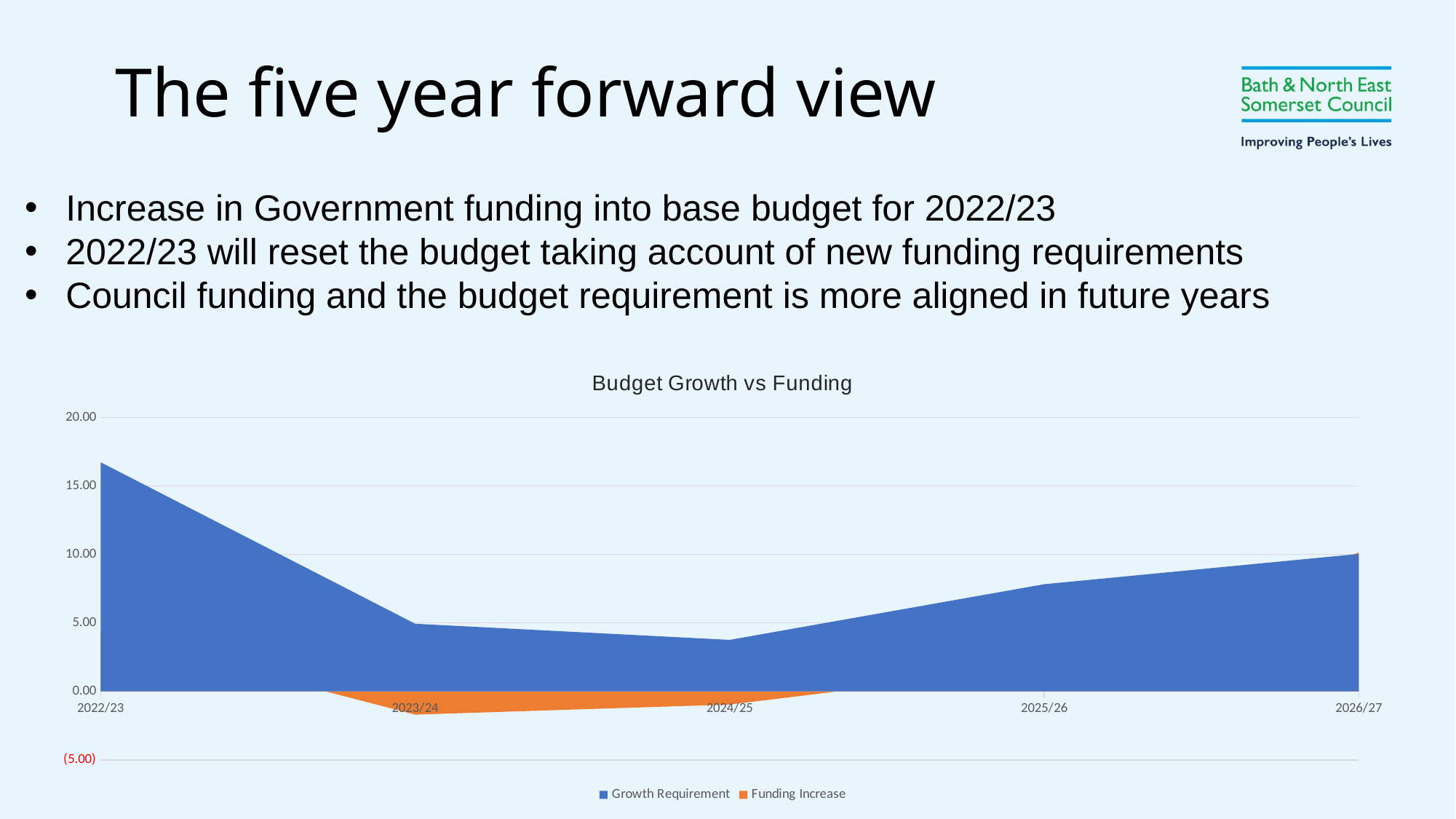
Is the Growth Requirement for 2024/25 greater or less than 5.00? less Which year has the highest Growth Requirement? 2022/23 Which series is shown in orange in the chart? Funding Increase How many years are shown on the x axis of the chart? 5 What type of chart is shown on the slide? Area chart Does the Growth Requirement rise or fall from 2022/23 to 2024/25? fall What is the title of the chart? Budget Growth vs Funding How many series does the chart legend list? 2 Which year has the lowest Growth Requirement? 2024/25 Is the Funding Increase for 2023/24 greater or less than 0.00? less Is the Growth Requirement for 2022/23 greater or less than 15.00? greater